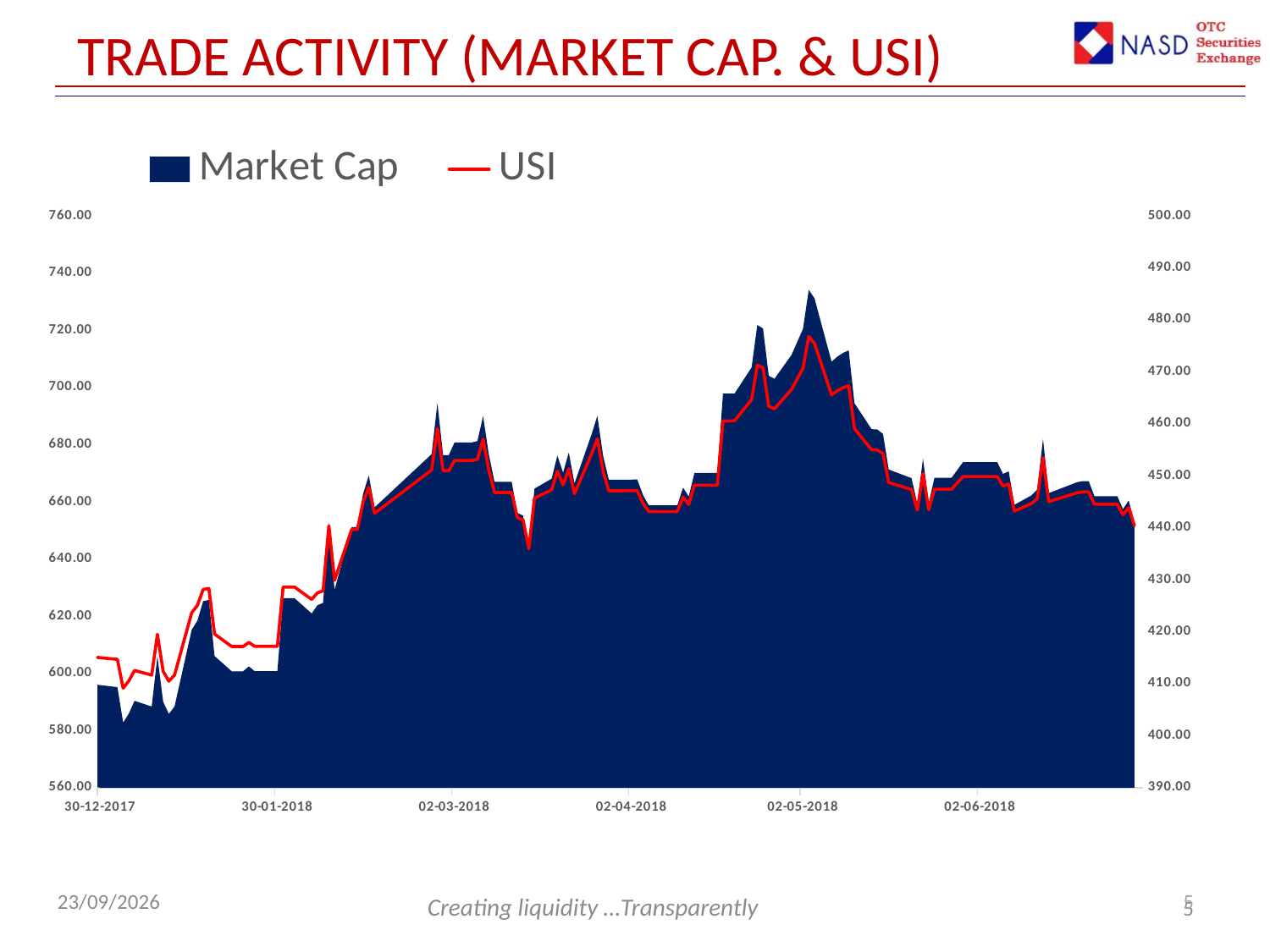
What kind of chart is used for the USI series? Line chart What kind of chart is used for the Market Cap series? Area chart Does Market Cap generally rise or fall between 30-12-2017 and 02-05-2018? rise How many date labels are shown on the x axis? 6 How many series does the legend list? 2 What is the title of the chart? TRADE ACTIVITY (MARKET CAP. & USI) What are the two series named in the legend? Market Cap and USI Is the Market Cap value at the last point on the right greater or less than 680.00? less Does Market Cap generally rise or fall from its peak near 02-05-2018 to the end of the chart? fall Is the peak value of USI, reached shortly after 02-05-2018, greater or less than 470.00? greater